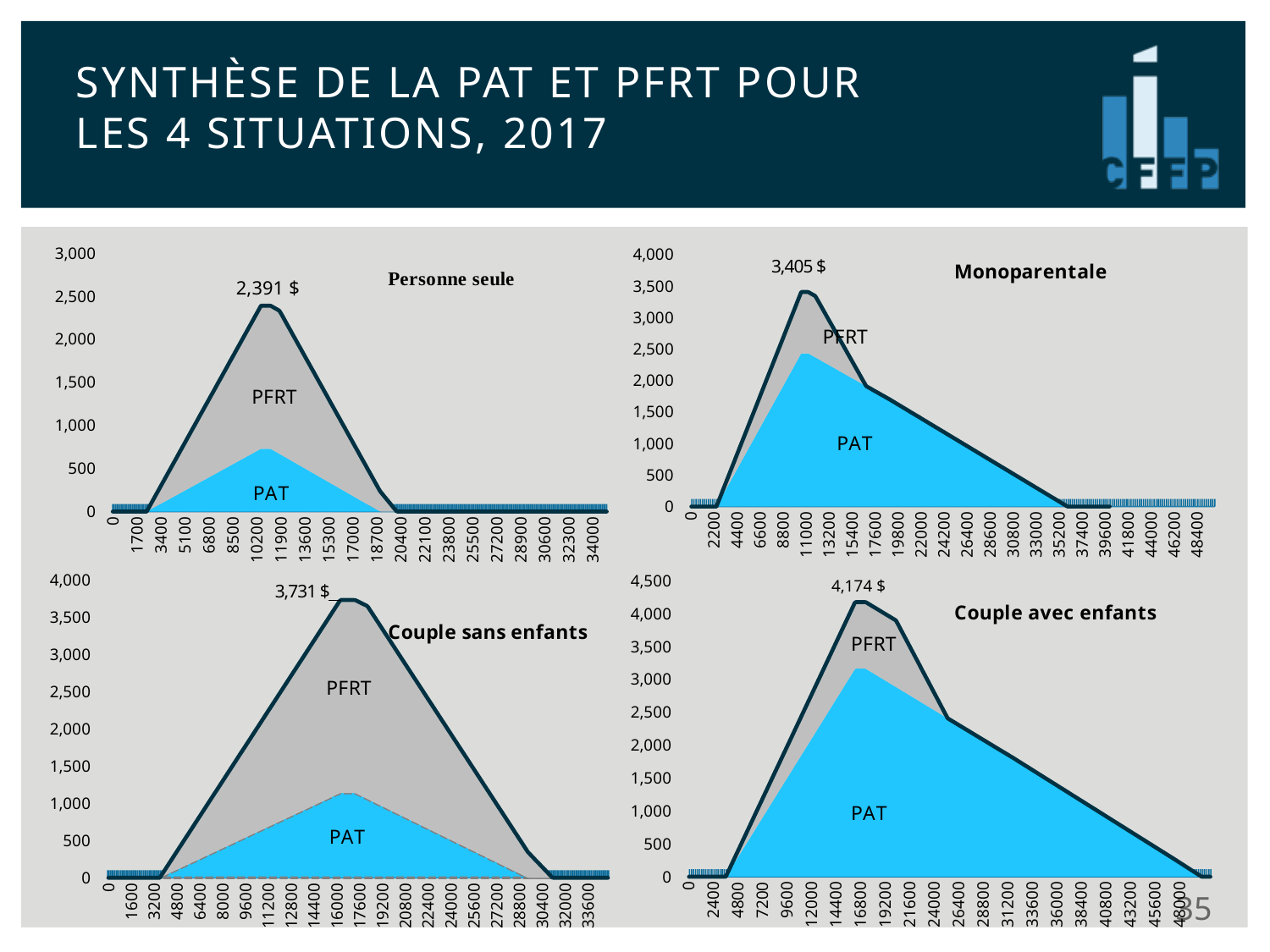
Across the four charts, which situation has the lowest labelled peak value? Personne seule In the 'Couple sans enfants' chart, which area is shown in blue, PAT or PFRT? PAT Across the four charts, which situation has the highest labelled peak value? Couple avec enfants In the 'Personne seule' chart, what is the peak value printed on the chart? 2,391 $ What is the difference between the labelled peak in the 'Couple avec enfants' chart and the labelled peak in the 'Personne seule' chart? 1,783 $ What kind of chart is the 'Monoparentale' chart? area chart In the 'Couple avec enfants' chart, what is the peak value printed on the chart? 4,174 $ Which labelled peak is larger: the one in the 'Couple sans enfants' chart or the one in the 'Monoparentale' chart? Couple sans enfants In the 'Monoparentale' chart, what is the peak value printed on the chart? 3,405 $ In the 'Personne seule' chart, is the highest point of the PAT area greater or less than 1,000? less In the 'Couple avec enfants' chart, is the highest point of the PAT area greater or less than 3,000? greater In the 'Couple sans enfants' chart, what is the peak value printed on the chart? 3,731 $